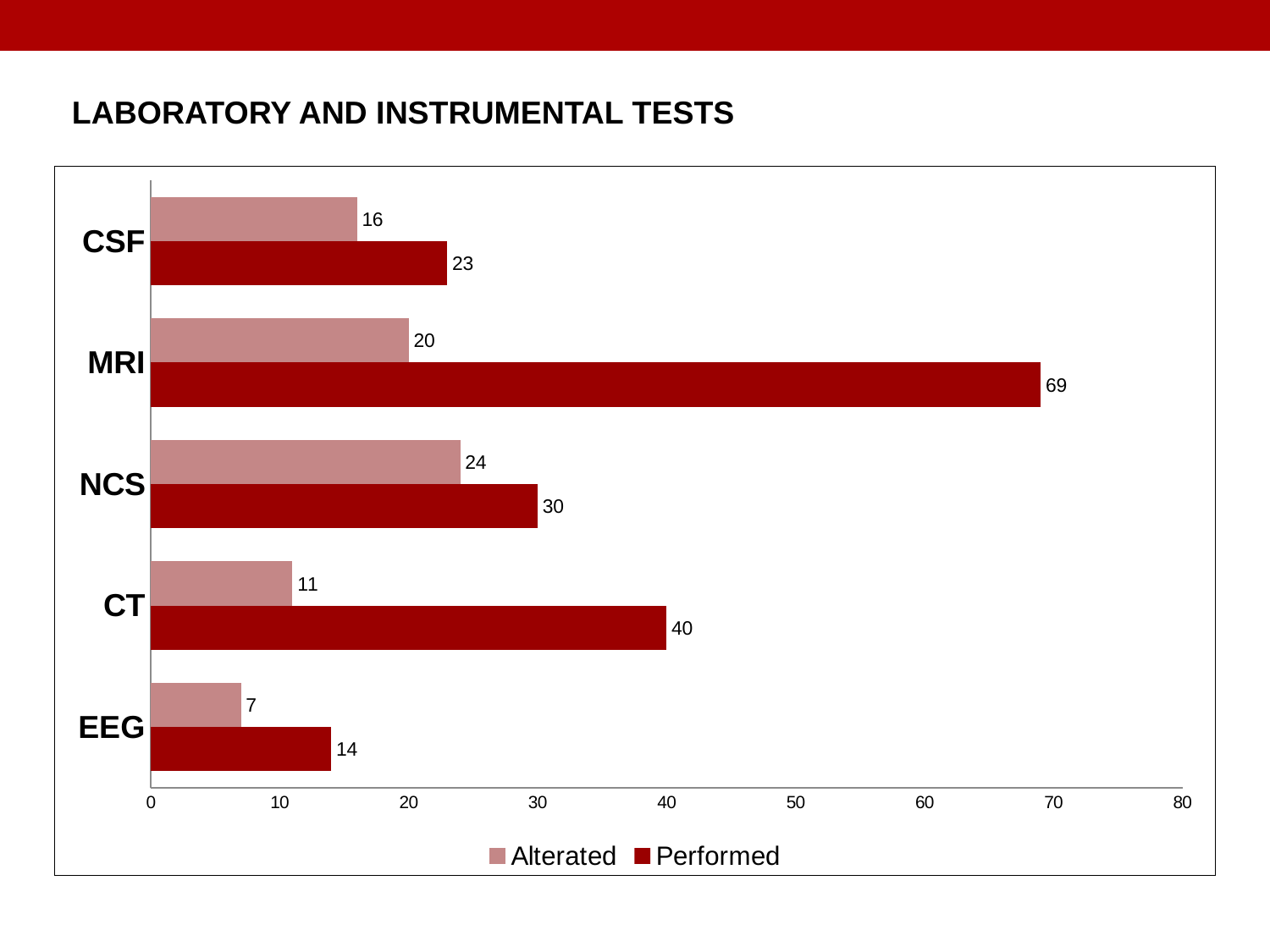
What is the title of the slide? LABORATORY AND INSTRUMENTAL TESTS What is the Performed value for MRI? 69 What is the difference between the Performed and Alterated values for CT? 29 Is the Performed value for NCS greater or less than 20? greater Which is larger, the Alterated value for NCS or the Alterated value for CSF? NCS What is the Alterated value for CT? 11 What is the Performed value for EEG? 14 How many tests are shown on the chart? 5 Which test has the highest Performed value? MRI Which test has the lowest Alterated value? EEG How many series does the legend list? 2 What kind of chart is shown on the slide? bar chart